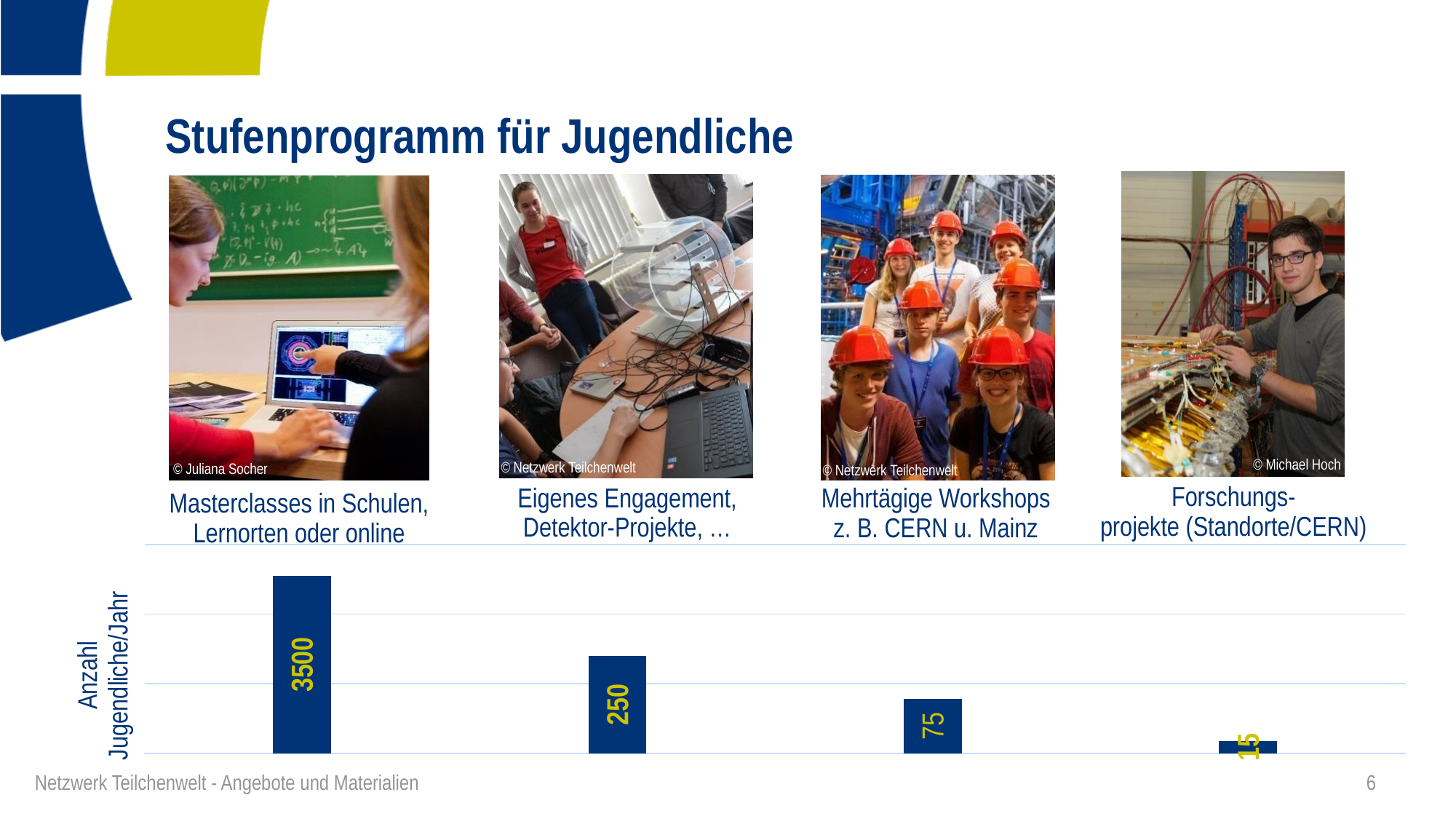
Which program stage has the lowest number of Jugendliche/Jahr? Forschungsprojekte (Standorte/CERN) What value is shown for the Forschungsprojekte bar? 15 What value is shown for the Eigenes Engagement / Detektor-Projekte bar? 250 What is the difference between the Masterclasses value and the Eigenes Engagement value? 3250 Which program stage has the highest number of Jugendliche/Jahr? Masterclasses in Schulen, Lernorten oder online What value is shown for the Masterclasses bar in the chart? 3500 What value is shown for the Mehrtägige Workshops bar? 75 What is the difference between the Mehrtägige Workshops value and the Forschungsprojekte value? 60 How many bars are shown in the chart? 4 What kind of chart is shown on the slide? Bar chart Do the values rise or fall from left to right across the bars? Fall Which is larger: the value for Mehrtägige Workshops or the value for Forschungsprojekte? Mehrtägige Workshops